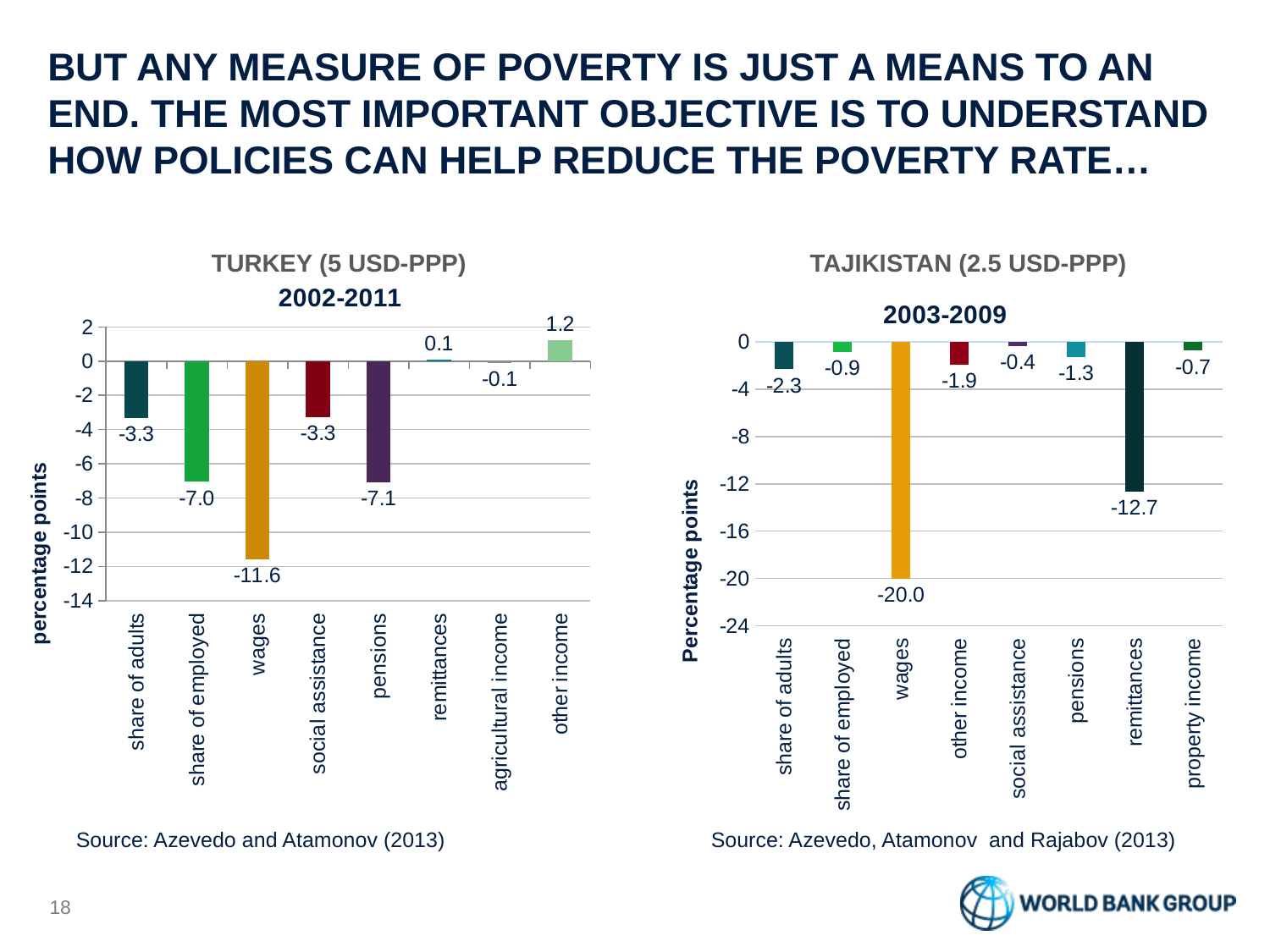
In the Turkey (5 USD-PPP) chart, how many categories are shown on the x axis? 8 In the Turkey (5 USD-PPP) chart, what is the value for wages? -11.6 In the Turkey (5 USD-PPP) chart, what is the value for pensions? -7.1 In the Tajikistan (2.5 USD-PPP) chart, which category has the lowest value? wages What kind of chart is the Tajikistan (2.5 USD-PPP) chart? bar chart In the Tajikistan (2.5 USD-PPP) chart, what is the value for other income? -1.9 In the Turkey (5 USD-PPP) chart, what is the difference between the values for share of employed and share of adults? 3.7 In the Tajikistan (2.5 USD-PPP) chart, what is the difference between the values for wages and remittances? 7.3 In the Tajikistan (2.5 USD-PPP) chart, what is the value for remittances? -12.7 In the Turkey (5 USD-PPP) chart, which category has the highest value? other income In the Turkey (5 USD-PPP) chart, which category has the lowest value? wages In the Tajikistan (2.5 USD-PPP) chart, which is larger, the value for share of adults or the value for pensions? pensions